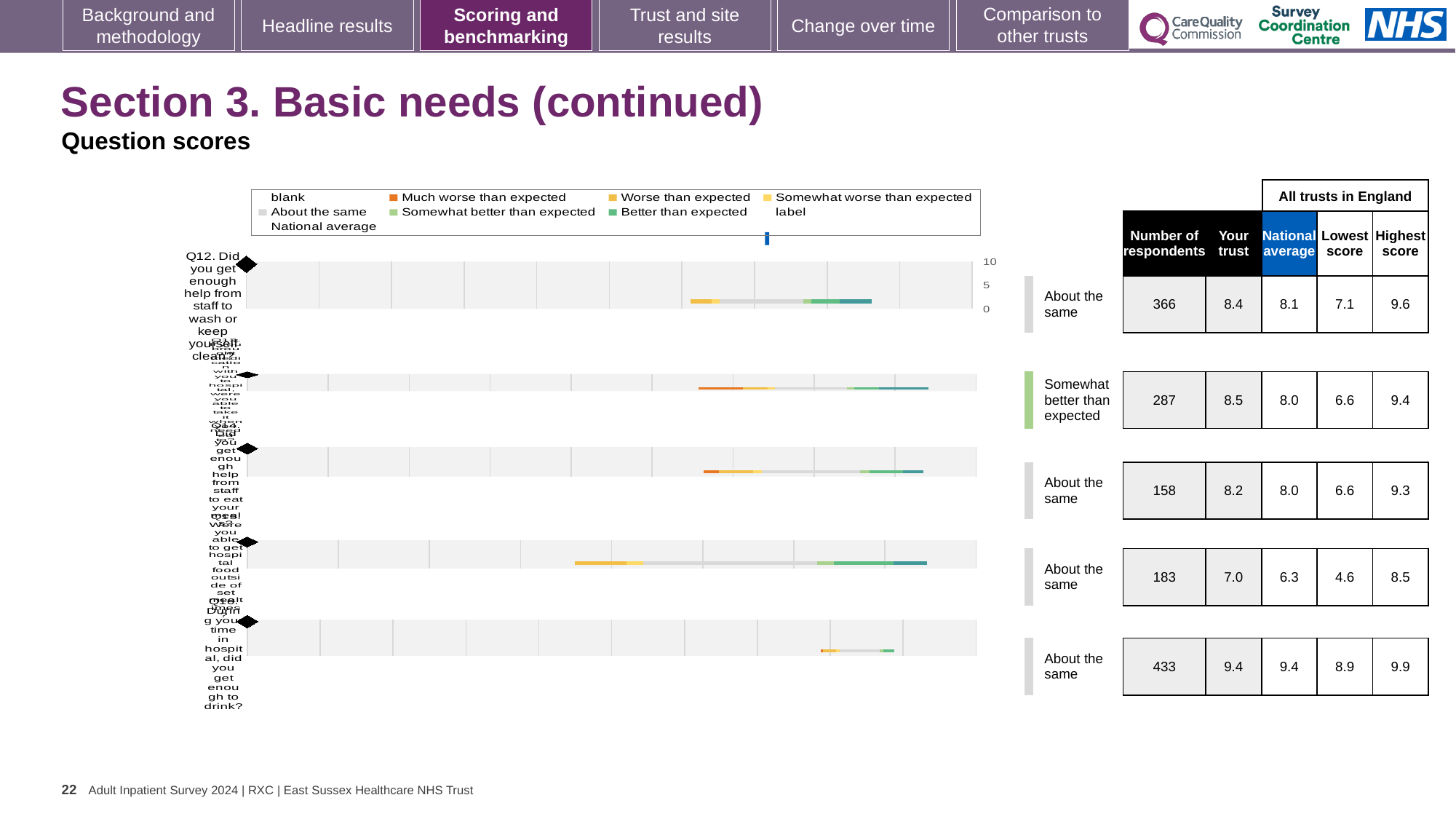
For Q12 (the first row), what is the difference between the highest score and the lowest score across all trusts in England? 2.5 What benchmark category is shown for the second row of the chart? Somewhat better than expected What is the highest 'Your trust' score shown in the table? 9.4 How many of the five rows are labelled 'About the same'? 4 In the table, what is the national average for Q12 (the first row)? 8.1 In the table, what is the number of respondents for Q12 (the first row)? 366 For Q12 (the first row), which is larger: the 'Your trust' score or the national average? Your trust What colour represents 'Much worse than expected' in the legend? orange How many question rows (bars) are plotted in the chart? 5 What is the lowest 'Your trust' score shown in the table? 7.0 What kind of chart is shown on the slide? bar chart In the table, what is the 'Your trust' score for Q12 (the first row)? 8.4